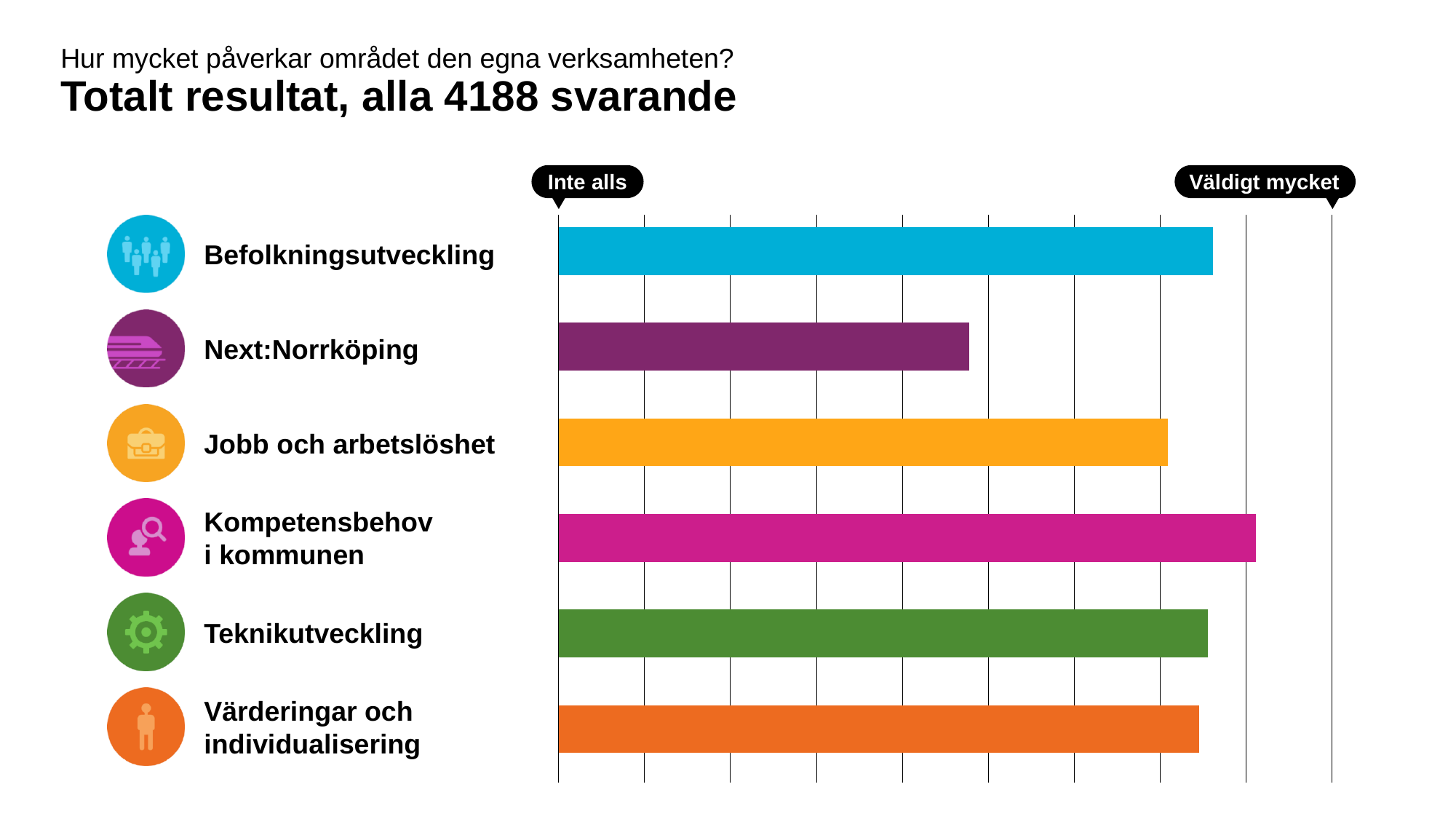
What label marks the right end of the chart's scale? Väldigt mycket Which bar is longer: Värderingar och individualisering or Jobb och arbetslöshet? Värderingar och individualisering What kind of chart is shown on the slide? bar chart Which category has the shortest bar in the chart? Next:Norrköping Which category has the longest bar in the chart? Kompetensbehov i kommunen How many categories (areas) are plotted in the chart? 6 Which bar is longer: Befolkningsutveckling or Jobb och arbetslöshet? Befolkningsutveckling Which bar is longer: Next:Norrköping or Teknikutveckling? Teknikutveckling What label marks the left end of the chart's scale? Inte alls